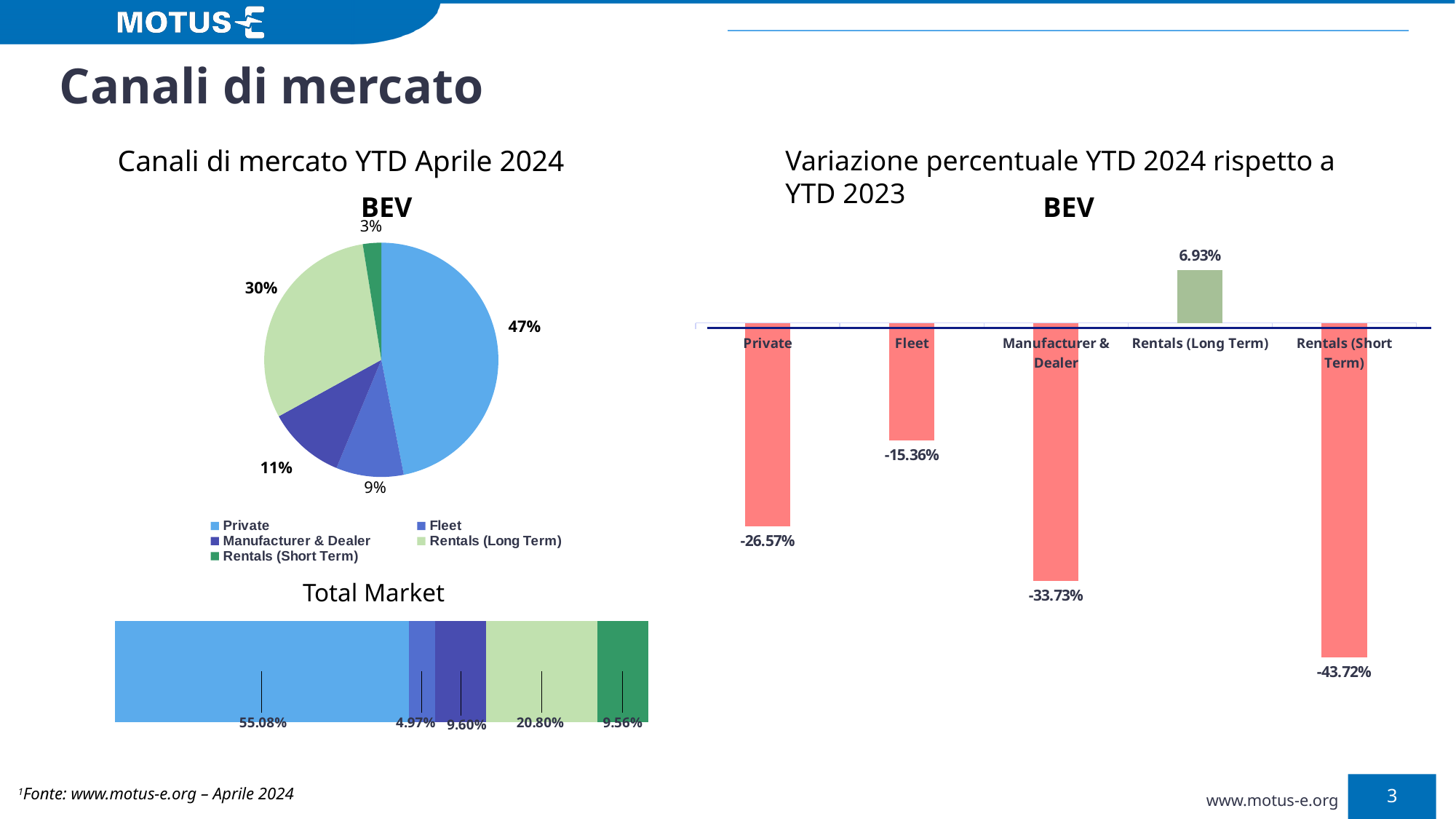
In the BEV pie chart, which category has the largest slice? Private In the BEV pie chart, what share does Private hold? 47% In the Total Market stacked bar, what is the value of the light green segment? 20.80% In the 'Variazione percentuale YTD 2024 rispetto a YTD 2023' chart, which category is the only one with a positive value? Rentals (Long Term) In the BEV pie chart, how many categories does the legend list? 5 In the Total Market stacked bar, what is the value of the largest (light blue) segment? 55.08% In the 'Variazione percentuale YTD 2024 rispetto a YTD 2023' chart, what is the value for Manufacturer & Dealer? -33.73% In the BEV pie chart, what is the difference between the Private share and the Rentals (Long Term) share? 17% In the BEV pie chart, which category has the smallest slice? Rentals (Short Term) In the BEV pie chart, what share does Rentals (Long Term) hold? 30% What kind of chart is the 'Variazione percentuale YTD 2024 rispetto a YTD 2023' chart? Bar chart In the 'Variazione percentuale YTD 2024 rispetto a YTD 2023' chart, what is the value for Rentals (Short Term)? -43.72%